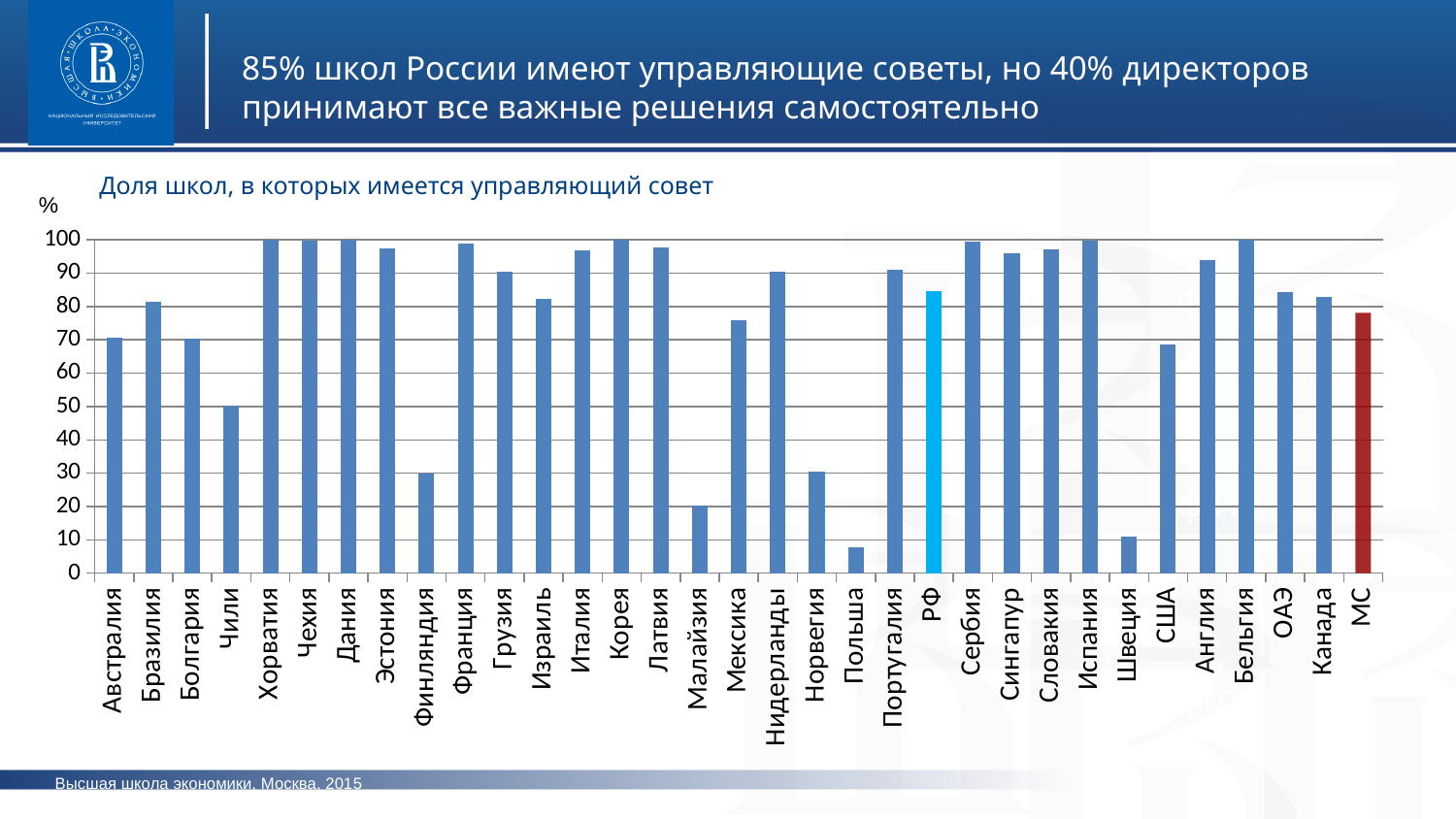
Which category has the lowest value in the chart? Польша Is the value for Швеция greater or less than 20? less Which is larger, the value for Бразилия or the value for Чили? Бразилия What kind of chart is shown on the slide? bar chart Is the value for МС greater or less than 80? less How many countries/categories are shown on the x axis of the chart? 33 Which bar is highlighted in red in the chart? МС Is the value for Мексика greater or less than 80? less Which is larger, the value for Норвегия or the value for Малайзия? Норвегия What is the title of the chart? Доля школ, в которых имеется управляющий совет